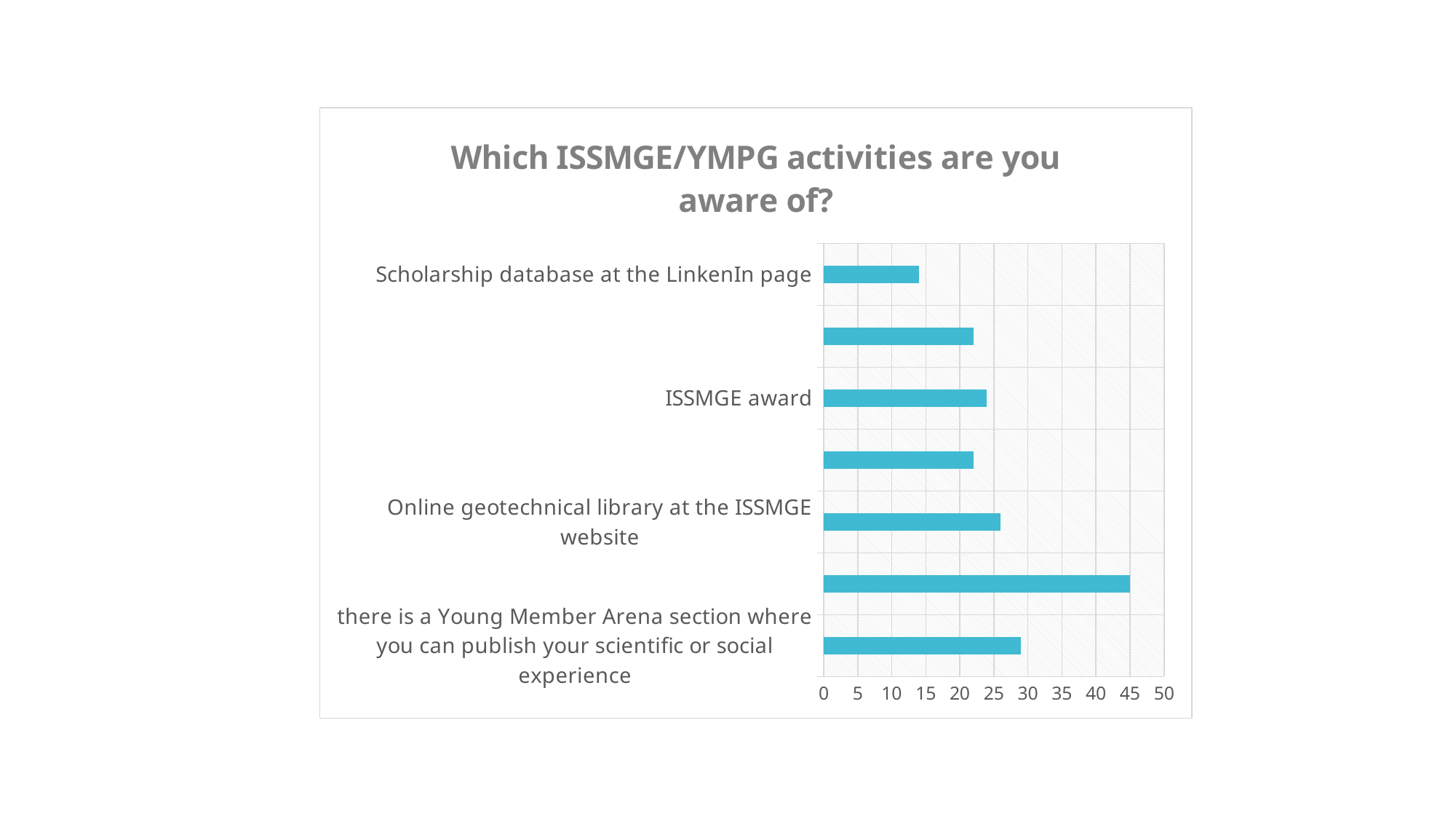
Which category has the lowest value in the chart? Scholarship database at the LinkenIn page What is the title of the chart? Which ISSMGE/YMPG activities are you aware of? Is the value for 'ISSMGE award' greater or less than 25? less Is the value for 'Scholarship database at the LinkenIn page' greater or less than 10? greater Is the value for 'Scholarship database at the LinkenIn page' greater or less than 15? less How many bars are plotted in the chart? 7 Which is larger: the value for 'ISSMGE award' or the value for 'Scholarship database at the LinkenIn page'? ISSMGE award Which is larger: the value for 'there is a Young Member Arena section where you can publish your scientific or social experience' or the value for 'ISSMGE award'? there is a Young Member Arena section where you can publish your scientific or social experience What kind of chart is shown on the slide? bar chart